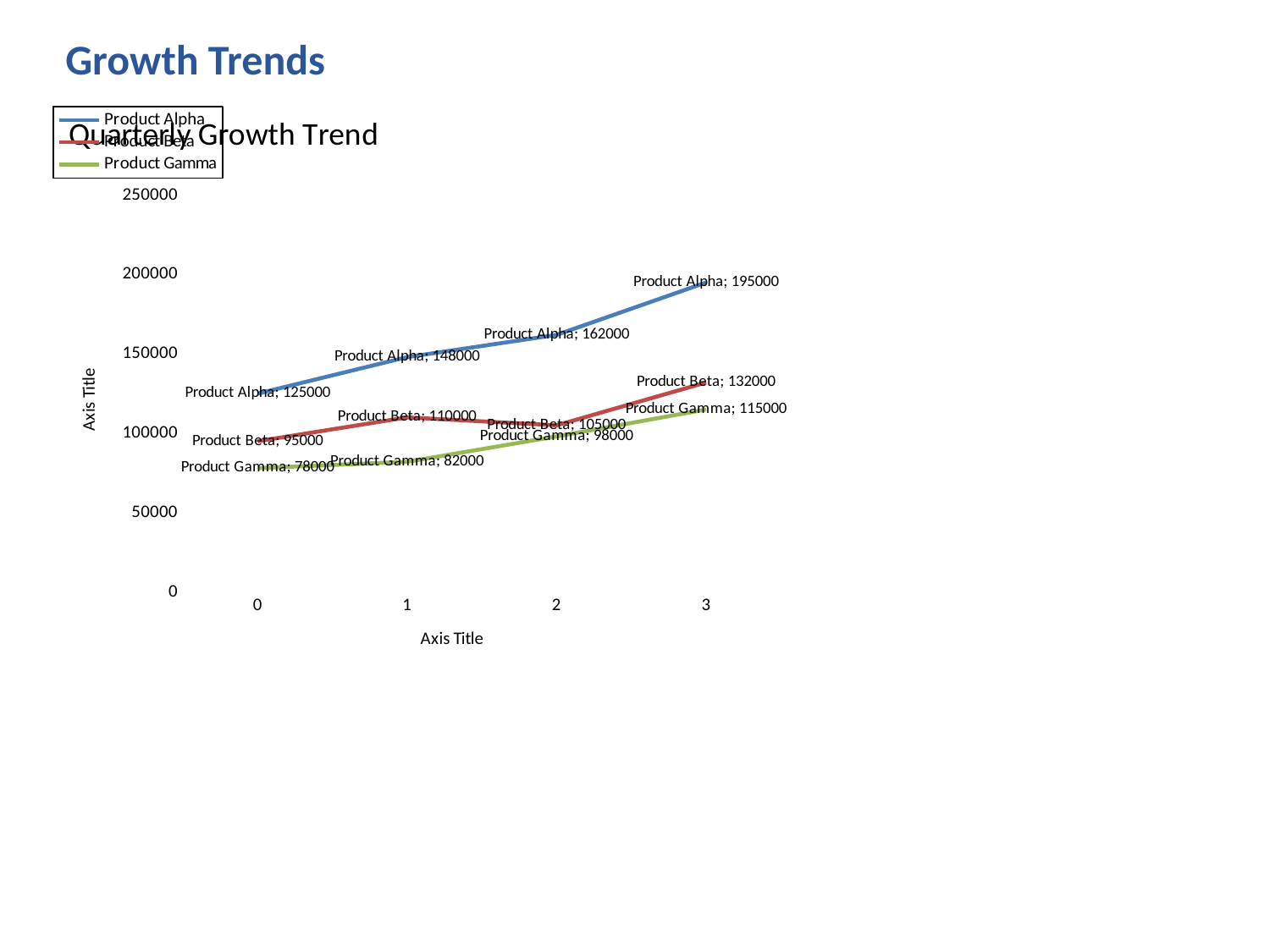
What is the value for Product Gamma at x = 0? 78000 What type of chart is shown on the slide? line chart What is the difference between Product Alpha and Product Beta at x = 3? 63000 What is the title of the chart? Quarterly Growth Trend What is the value for Product Alpha at x = 3? 195000 At which x value is Product Alpha highest? 3 Does Product Alpha rise or fall from x = 0 to x = 3? rise What is the value for Product Beta at x = 1? 110000 How many series does the legend list? 3 At which x value is Product Gamma lowest? 0 How many data points are plotted for each series? 4 Which is larger at x = 2: Product Beta or Product Gamma? Product Beta